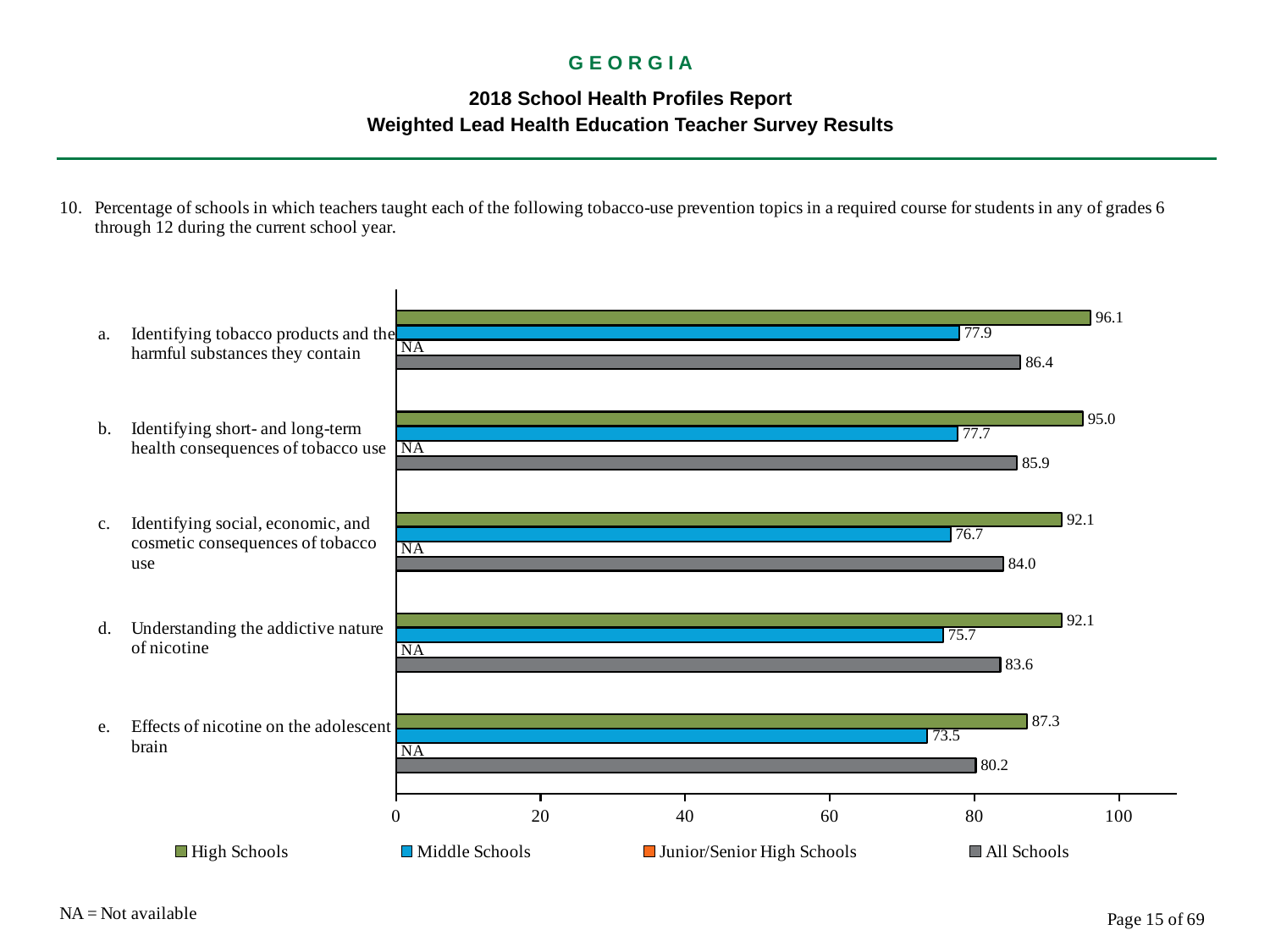
How many series does the legend list? 4 Which is larger for 'Identifying short- and long-term health consequences of tobacco use': the High Schools value or the All Schools value? High Schools Which topic has the lowest Middle Schools value? Effects of nicotine on the adolescent brain What is the High Schools value for 'Identifying tobacco products and the harmful substances they contain'? 96.1 What is shown for Junior/Senior High Schools for 'Identifying short- and long-term health consequences of tobacco use'? NA Which topic has the highest High Schools value? Identifying tobacco products and the harmful substances they contain How many topics are listed on the chart? 5 What is the difference between the High Schools and Middle Schools values for 'Identifying social, economic, and cosmetic consequences of tobacco use'? 15.4 What is the All Schools value for 'Understanding the addictive nature of nicotine'? 83.6 What is the Middle Schools value for 'Effects of nicotine on the adolescent brain'? 73.5 What type of chart is shown? Bar chart What does NA stand for according to the note on the slide? Not available